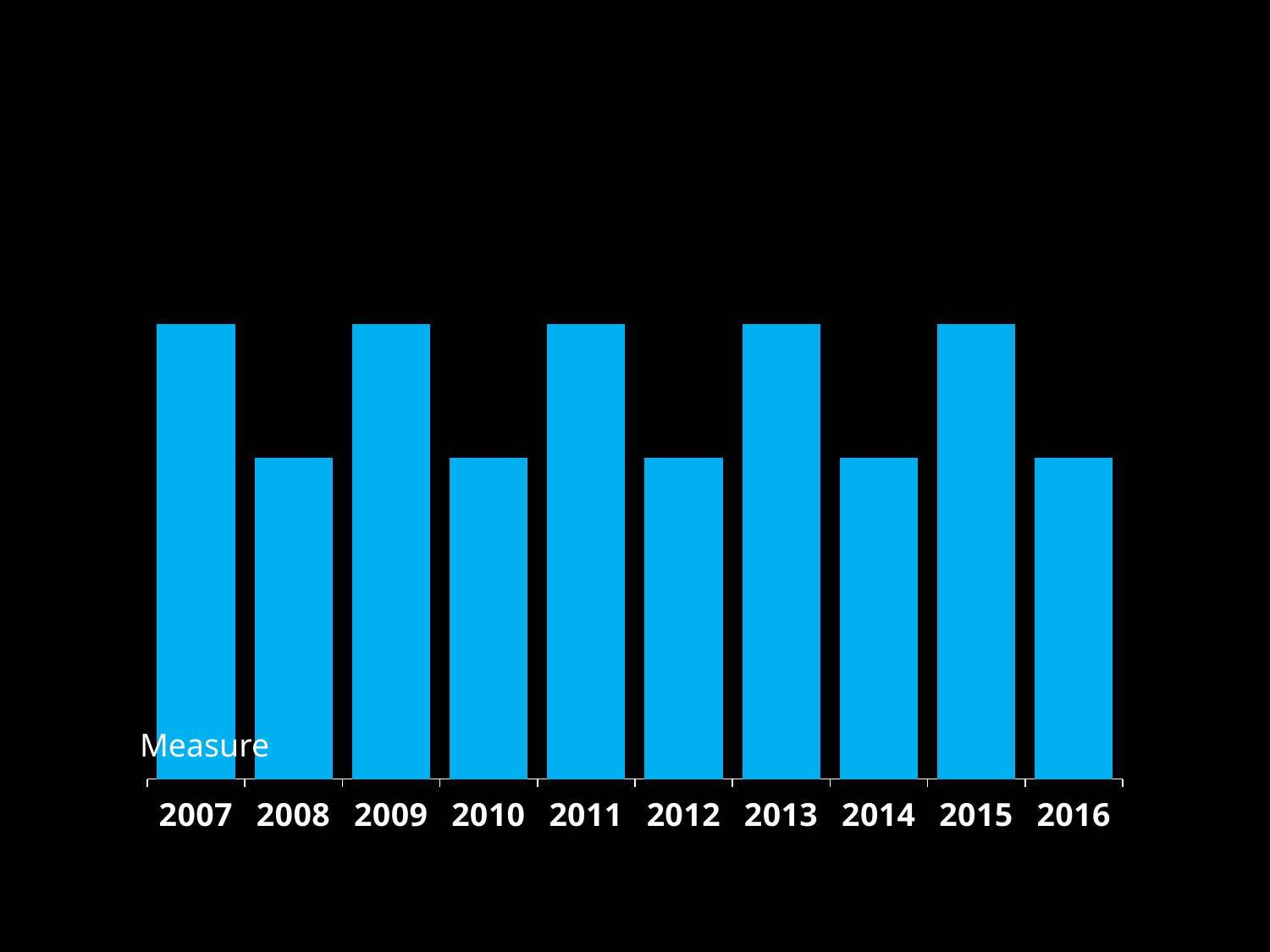
What text label appears at the bottom left of the plot area, just above the x axis? Measure Which is larger in the chart, the value for 2015 or the value for 2016? 2015 What is the first year shown on the x axis of the chart? 2007 What kind of chart is shown on the slide? bar chart Which is larger in the chart, the value for 2010 or the value for 2011? 2011 Do the values in the chart rise steadily, fall steadily, or alternate up and down from 2007 to 2016? alternate up and down Which is larger in the chart, the value for 2009 or the value for 2014? 2009 How many categories (years) are shown on the x axis of the chart? 10